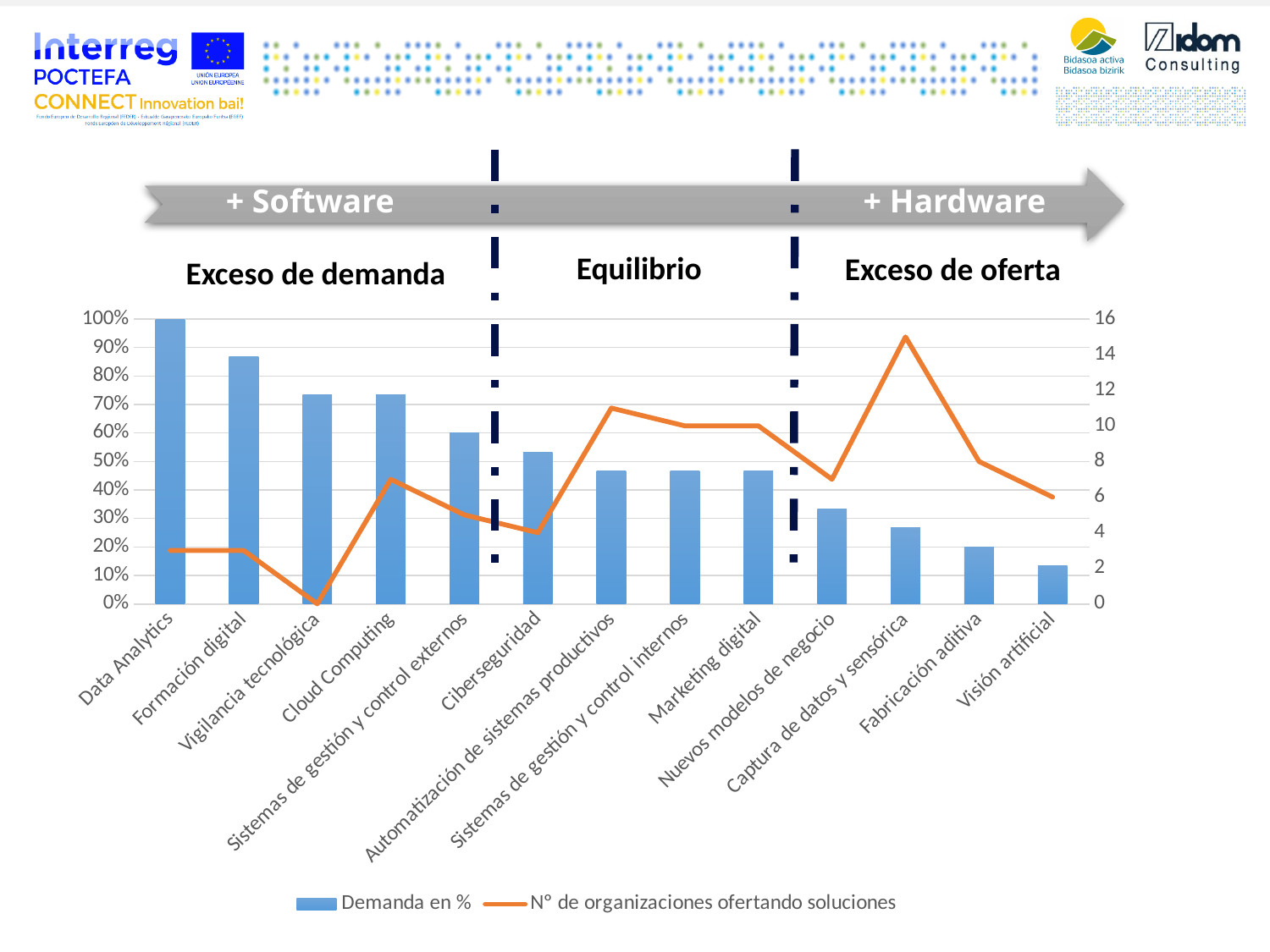
Is the N° de organizaciones ofertando soluciones value for Captura de datos y sensórica greater or less than 12? greater Which category has the highest value on the N° de organizaciones ofertando soluciones line? Captura de datos y sensórica Which category has the highest Demanda en % bar? Data Analytics What is the N° de organizaciones ofertando soluciones value for Fabricación aditiva? 8 How many series does the legend list? 2 How many organizations offer solutions (N° de organizaciones ofertando soluciones) for Vigilancia tecnológica? 0 How many categories are shown on the x axis of the chart? 13 Which category has the lowest Demanda en % bar? Visión artificial What kind of chart is shown on the slide? Combination bar and line chart Which has a higher Demanda en % value, Data Analytics or Visión artificial? Data Analytics What is the value of Demanda en % for Data Analytics? 100% Is the Demanda en % value for Formación digital greater or less than 80%? greater